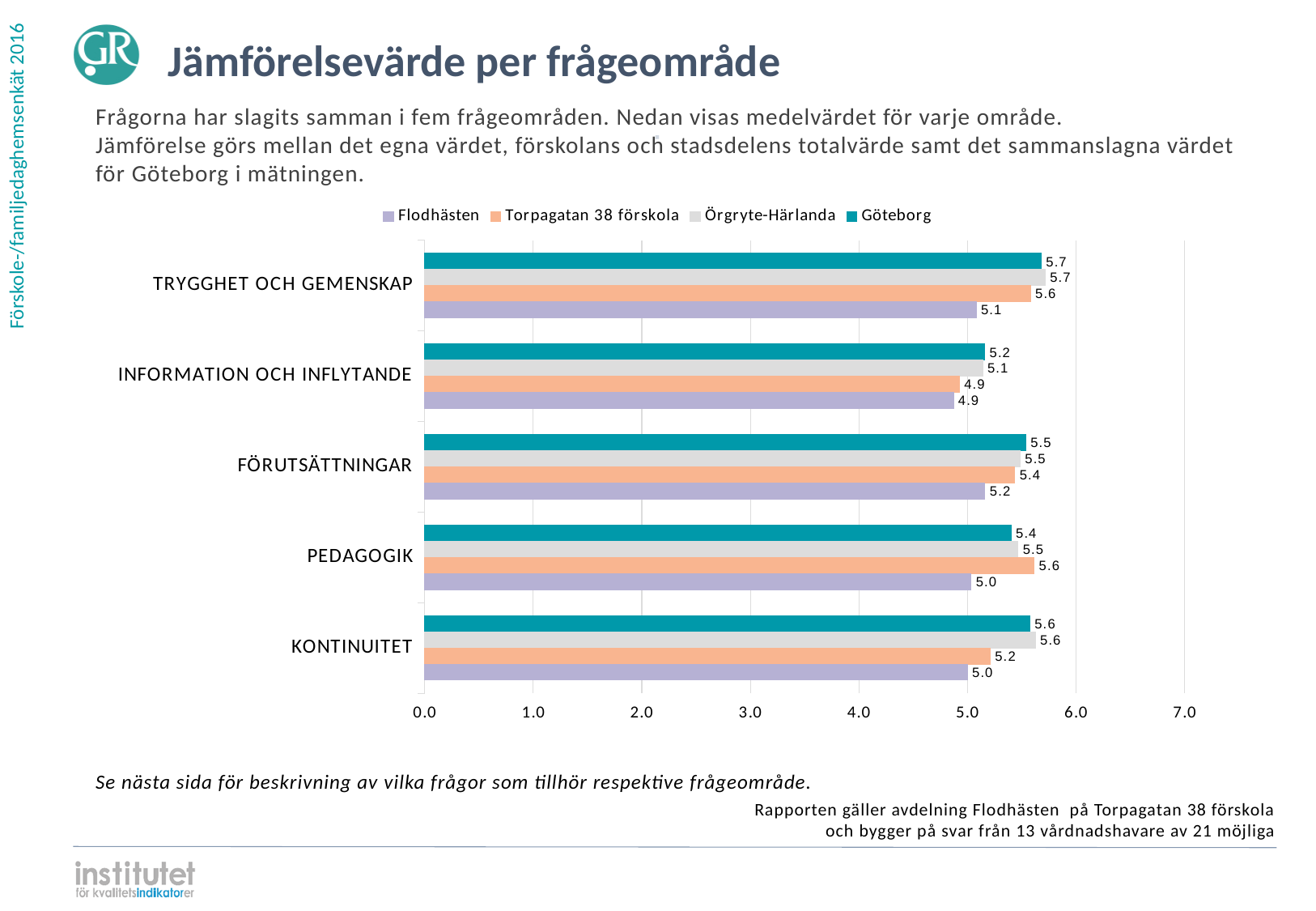
What is the value for Flodhästen in the TRYGGHET OCH GEMENSKAP category? 5.1 In the KONTINUITET category, which is larger: the value for Torpagatan 38 förskola or the value for Flodhästen? Torpagatan 38 förskola What is the value for Torpagatan 38 förskola in the PEDAGOGIK category? 5.6 What is the difference between the Göteborg value and the Flodhästen value in the TRYGGHET OCH GEMENSKAP category? 0.6 What is the value for Örgryte-Härlanda in the KONTINUITET category? 5.6 How many series does the legend list? 4 How many categories are shown on the chart? 5 In which category does Flodhästen have its lowest value? INFORMATION OCH INFLYTANDE What kind of chart is shown on the slide? Bar chart What is the value for Göteborg in the INFORMATION OCH INFLYTANDE category? 5.2 What is the difference between the Torpagatan 38 förskola value and the Flodhästen value in the PEDAGOGIK category? 0.6